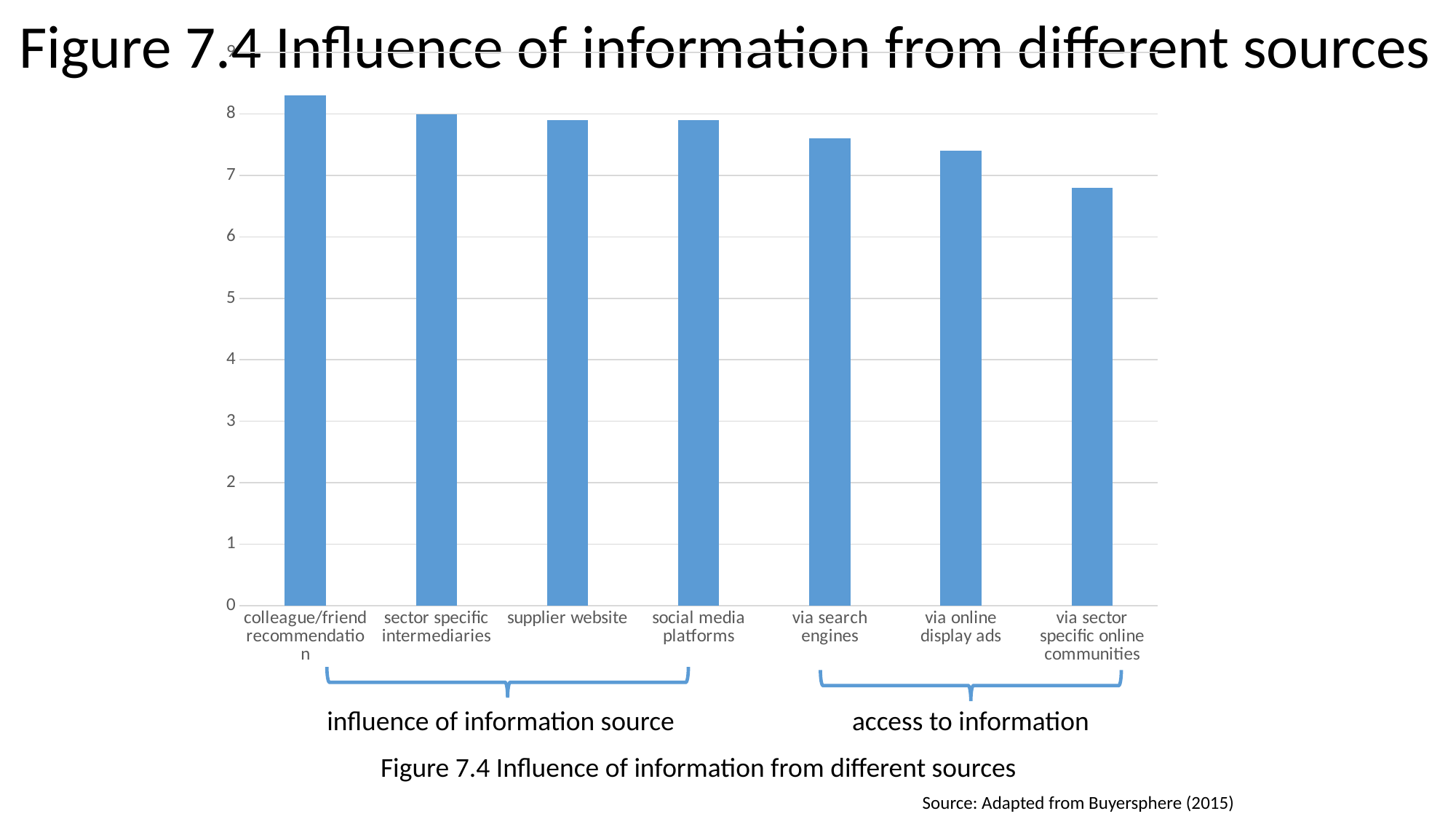
What kind of chart is shown on the slide? bar chart Is the value for via sector specific online communities greater or less than 7? less Which is larger, the value for via search engines or the value for via sector specific online communities? via search engines Which category has the lowest value? via sector specific online communities How many categories are plotted on the chart? 7 Which category has the highest value? colleague/friend recommendation Do the values generally rise or fall from left to right across the categories? fall Which is larger, the value for sector specific intermediaries or the value for via online display ads? sector specific intermediaries Which group label is shown under the bracket covering the first four categories? influence of information source Is the value for via online display ads greater or less than 7? greater Is the value for colleague/friend recommendation greater or less than 8? greater